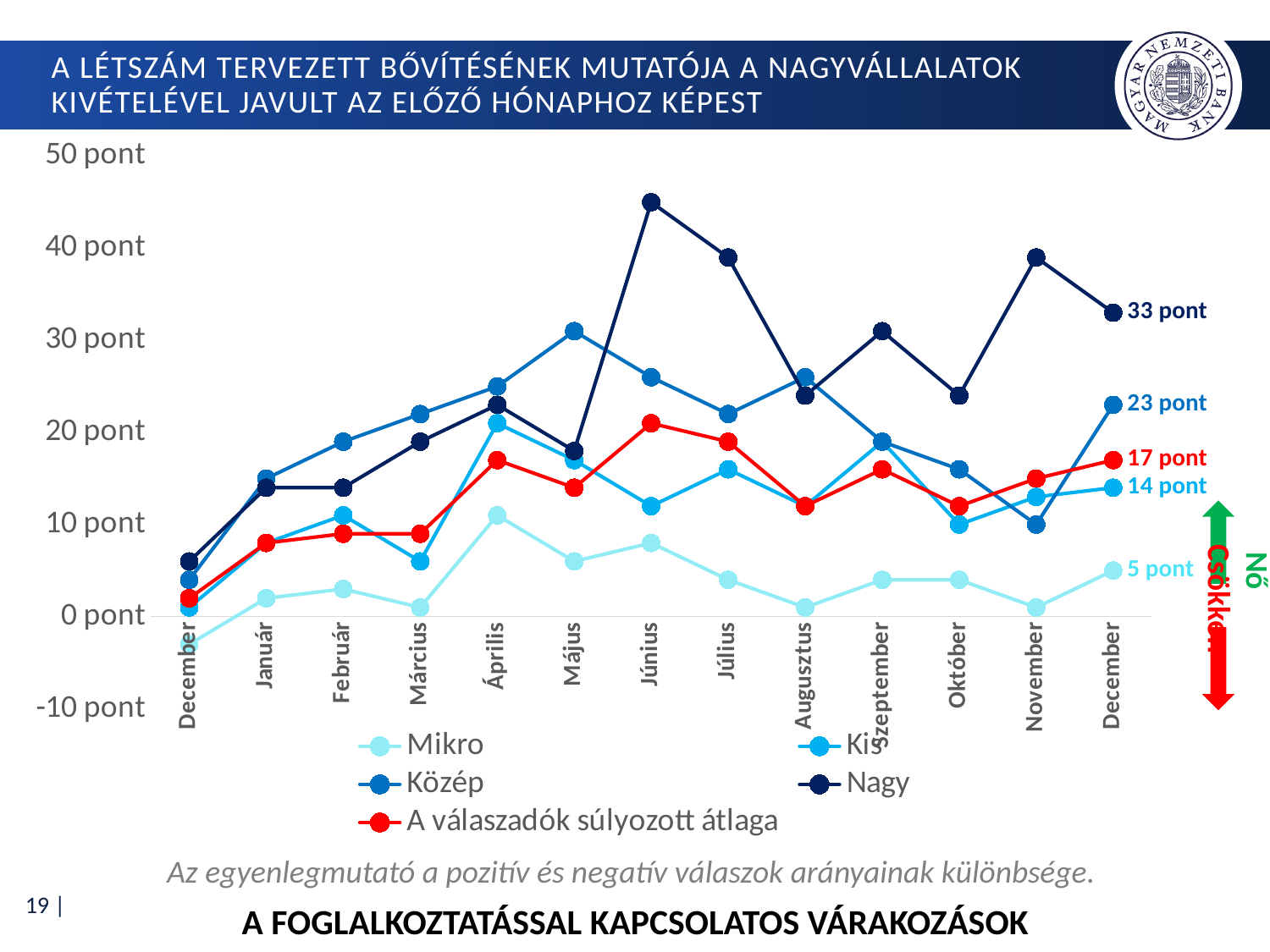
What is the value for the Kis series at the final December point? 14 pont What kind of chart is shown on the slide? Line chart How many series does the legend list? 5 What is the value for the Közép series at the final December point? 23 pont At the final December point, which series has the higher value: Kis or Mikro? Kis What is the value for the Nagy series at the final December point? 33 pont At the final December point, what is the difference between the Nagy and Közép values? 10 pont What is the value for 'A válaszadók súlyozott átlaga' at the final December point? 17 pont Which series has the highest value at the final December point? Nagy Is the value for the Nagy series in Június greater or less than 40 pont? greater What is the value for the Mikro series at the final December point? 5 pont Which series has the lowest value at the final December point? Mikro